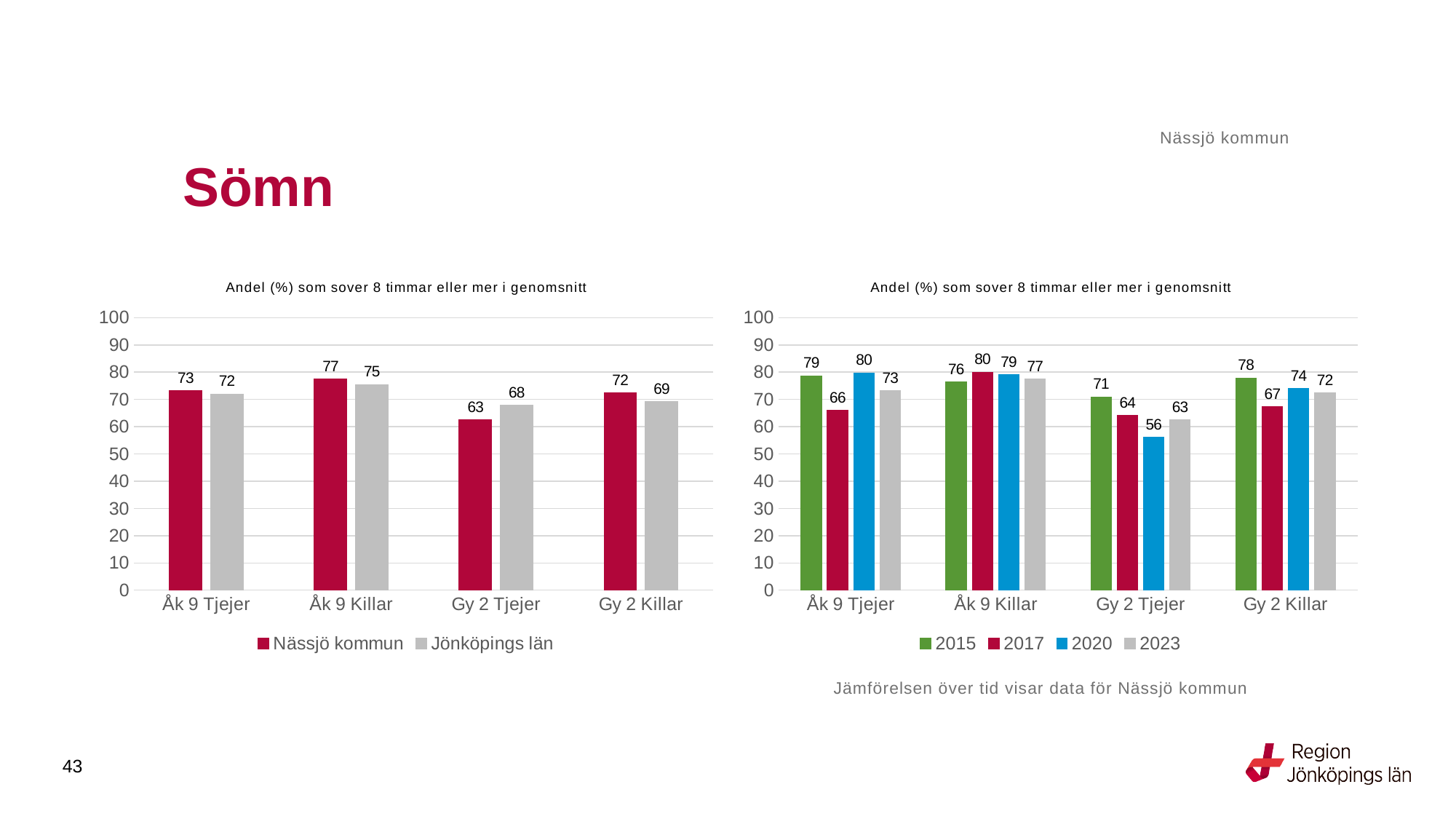
In the right chart, how many series does the legend list? 4 In the left chart, how many series does the legend list? 2 In the left chart, what is the value for Nässjö kommun for Åk 9 Killar? 77 In the right chart, what is the difference between the 2015 and 2020 values for Gy 2 Tjejer? 15 In the right chart, which is larger for Gy 2 Killar: 2015 or 2023? 2015 In the right chart, what is the value for 2017 for Åk 9 Killar? 80 What type of chart is the left chart? Bar chart In the left chart, which category has the lowest value for Nässjö kommun? Gy 2 Tjejer In the left chart, what is the difference between Nässjö kommun and Jönköpings län for Gy 2 Tjejer? 5 In the right chart, which year has the lowest value for Åk 9 Tjejer? 2017 In the left chart, what is the value for Jönköpings län for Gy 2 Tjejer? 68 In the right chart, what is the value for 2020 for Gy 2 Tjejer? 56